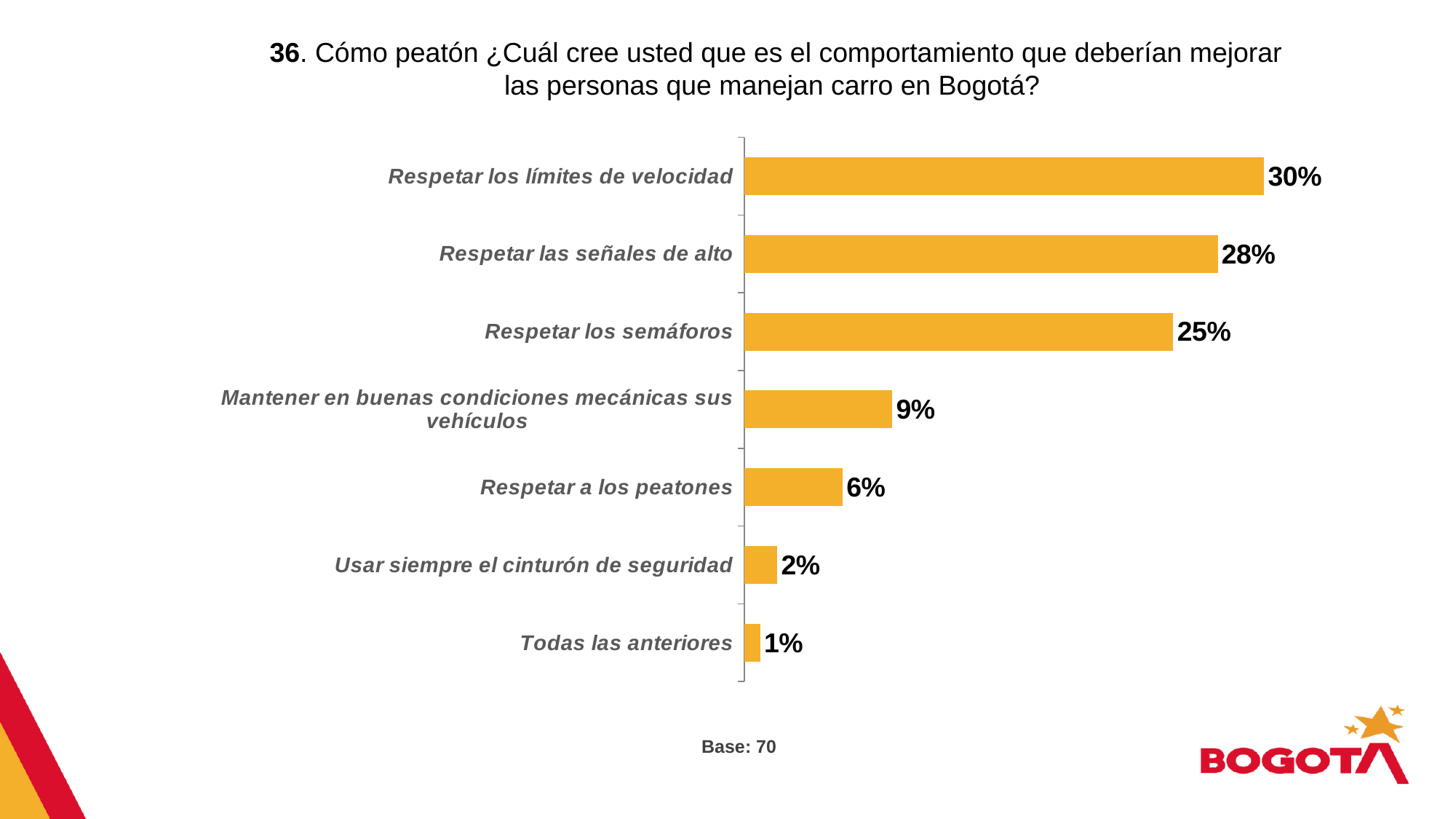
What is the value for "Respetar los límites de velocidad"? 30% What is the value for "Usar siempre el cinturón de seguridad"? 2% What is the value for "Mantener en buenas condiciones mecánicas sus vehículos"? 9% What is the difference between "Respetar las señales de alto" and "Respetar a los peatones"? 22% Which category has the lowest value? Todas las anteriores Which category has the highest value? Respetar los límites de velocidad What is the difference between "Respetar los límites de velocidad" and "Respetar los semáforos"? 5% What base (number of respondents) is stated below the chart? Base: 70 What kind of chart is shown on the slide? Bar chart What is the value for "Respetar los semáforos"? 25% How many categories are shown in the chart? 7 Which is larger, the value for "Respetar los semáforos" or the value for "Mantener en buenas condiciones mecánicas sus vehículos"? Respetar los semáforos